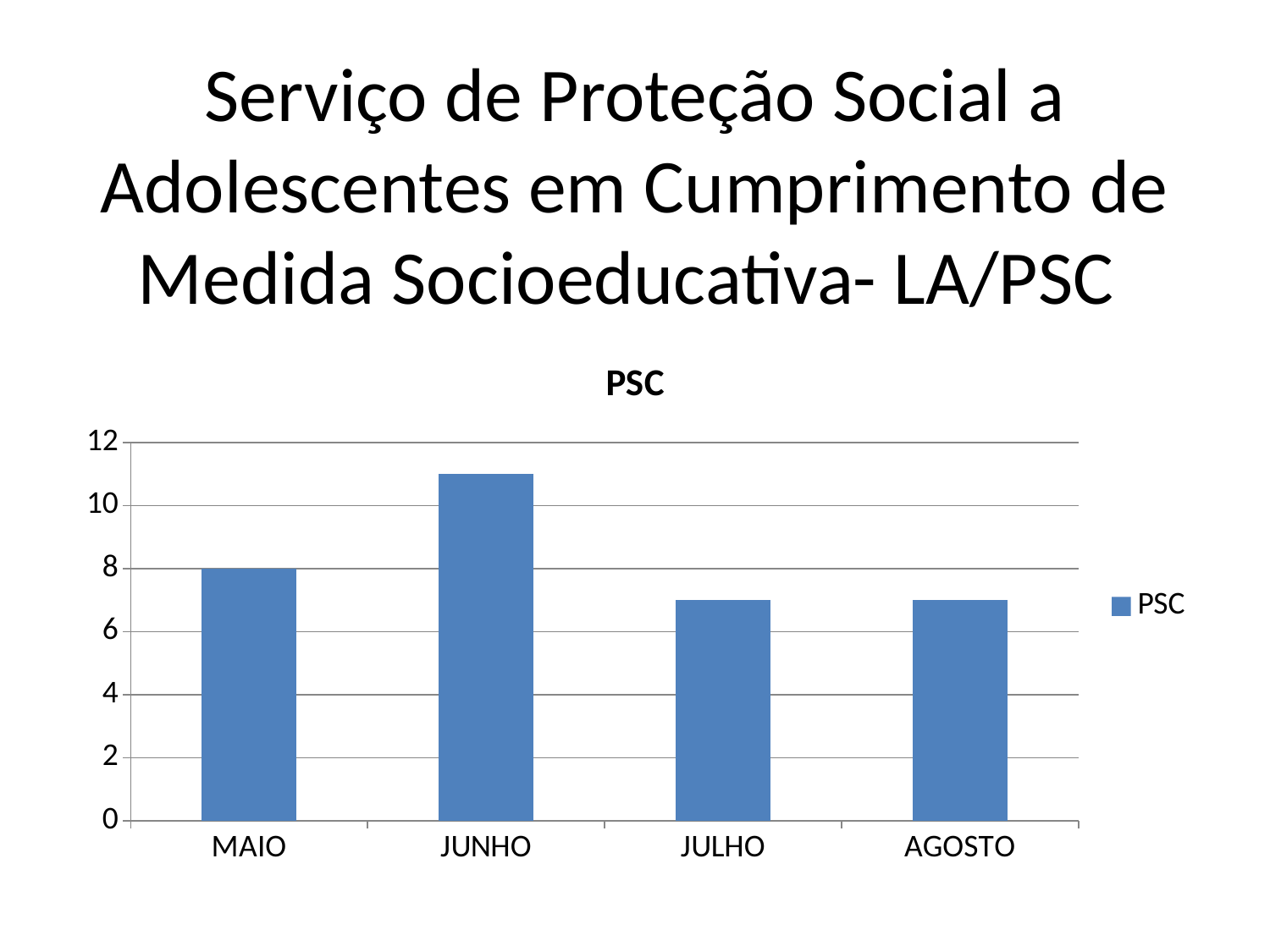
Is the value for AGOSTO greater or less than 6? greater How many months are shown on the x axis? 4 Which is larger, the value for JUNHO or the value for AGOSTO? JUNHO Is the value for JUNHO greater or less than 10? greater What is the value for MAIO? 8 Which month has the highest value? JUNHO What type of chart is shown on the slide? bar chart Which is larger, the value for MAIO or the value for JULHO? MAIO What is the title of the chart? PSC Is the value for JULHO greater or less than 8? less How many series does the legend list? 1 Does the value rise or fall from JUNHO to JULHO? fall